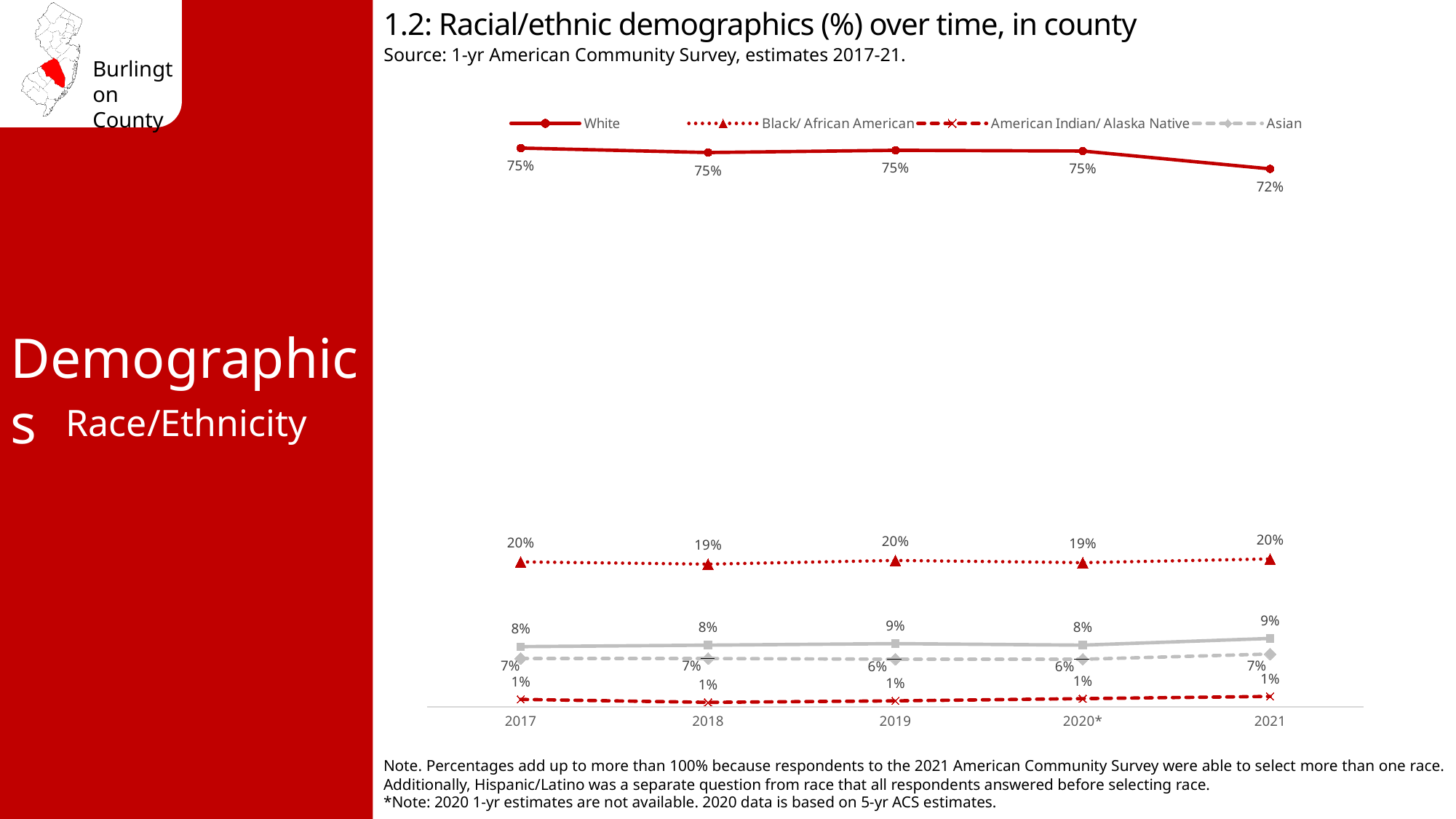
What is the difference between the White value in 2017 and in 2021? 3 percentage points In which year is the White series at its lowest value? 2021 What is the value for White in 2021? 72% What is the data source stated under the chart title? 1-yr American Community Survey, estimates 2017-21 Does the White series rise or fall from 2020* to 2021? Falls How many years are shown on the x axis? 5 What kind of chart is shown on the slide? Line chart What is the value for American Indian/ Alaska Native in 2020*? 1% What is the title of the chart? 1.2: Racial/ethnic demographics (%) over time, in county What is the value for Asian in 2017? 7% What is the value for Black/ African American in 2019? 20% In 2021, which is larger: Black/ African American or Asian? Black/ African American